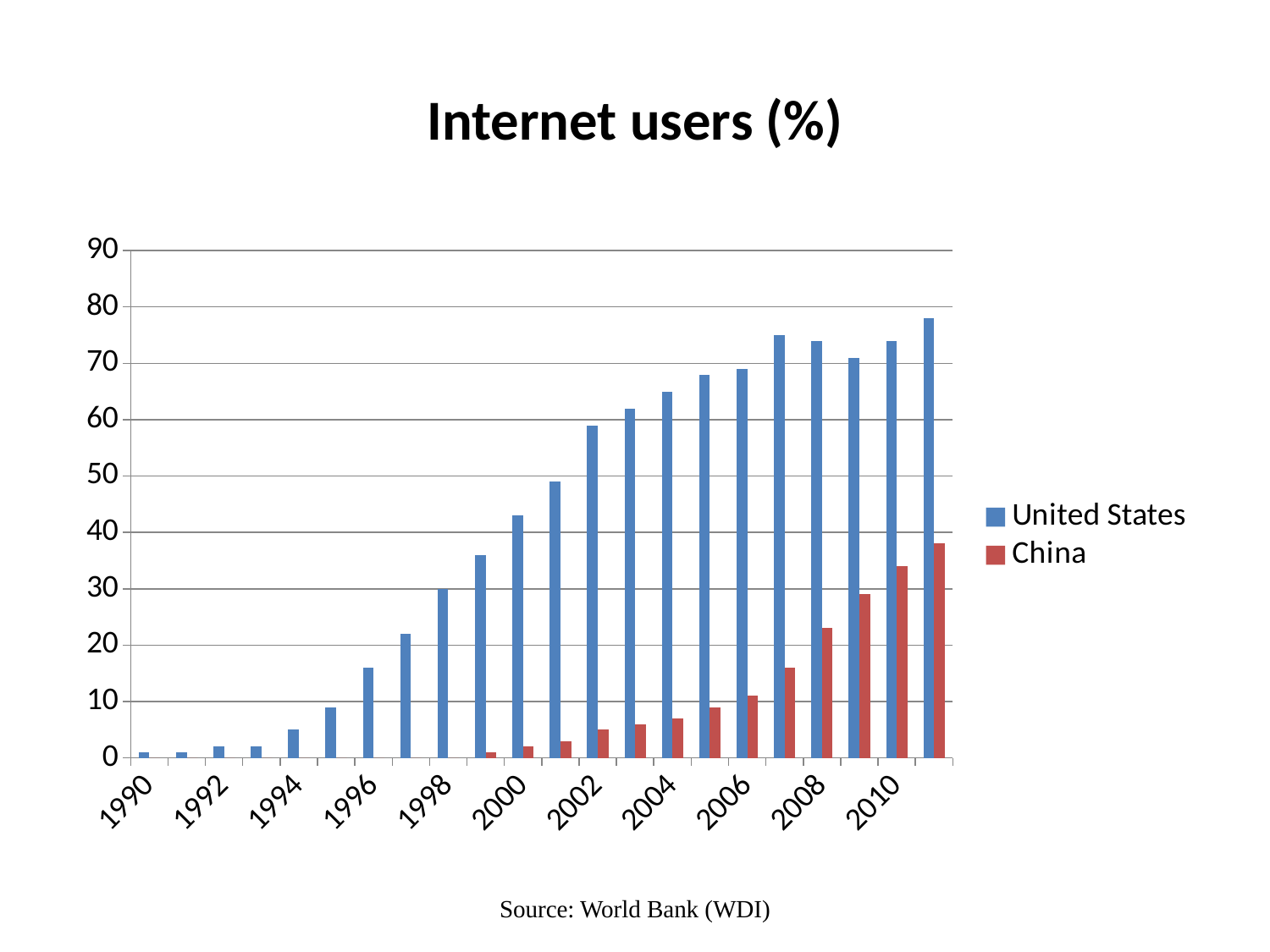
Is the value for China in 2010 greater or less than 30? greater Is the value for United States in 1996 greater or less than 10? greater How many series does the legend list? 2 Is the value for United States in 2004 greater or less than 60? greater Do the values for China rise or fall from 2000 to 2010? rise In 2010, which series has the higher value, United States or China? United States What source is cited below the chart? World Bank (WDI) What is the title of the chart? Internet users (%) What kind of chart is shown on the slide? bar chart